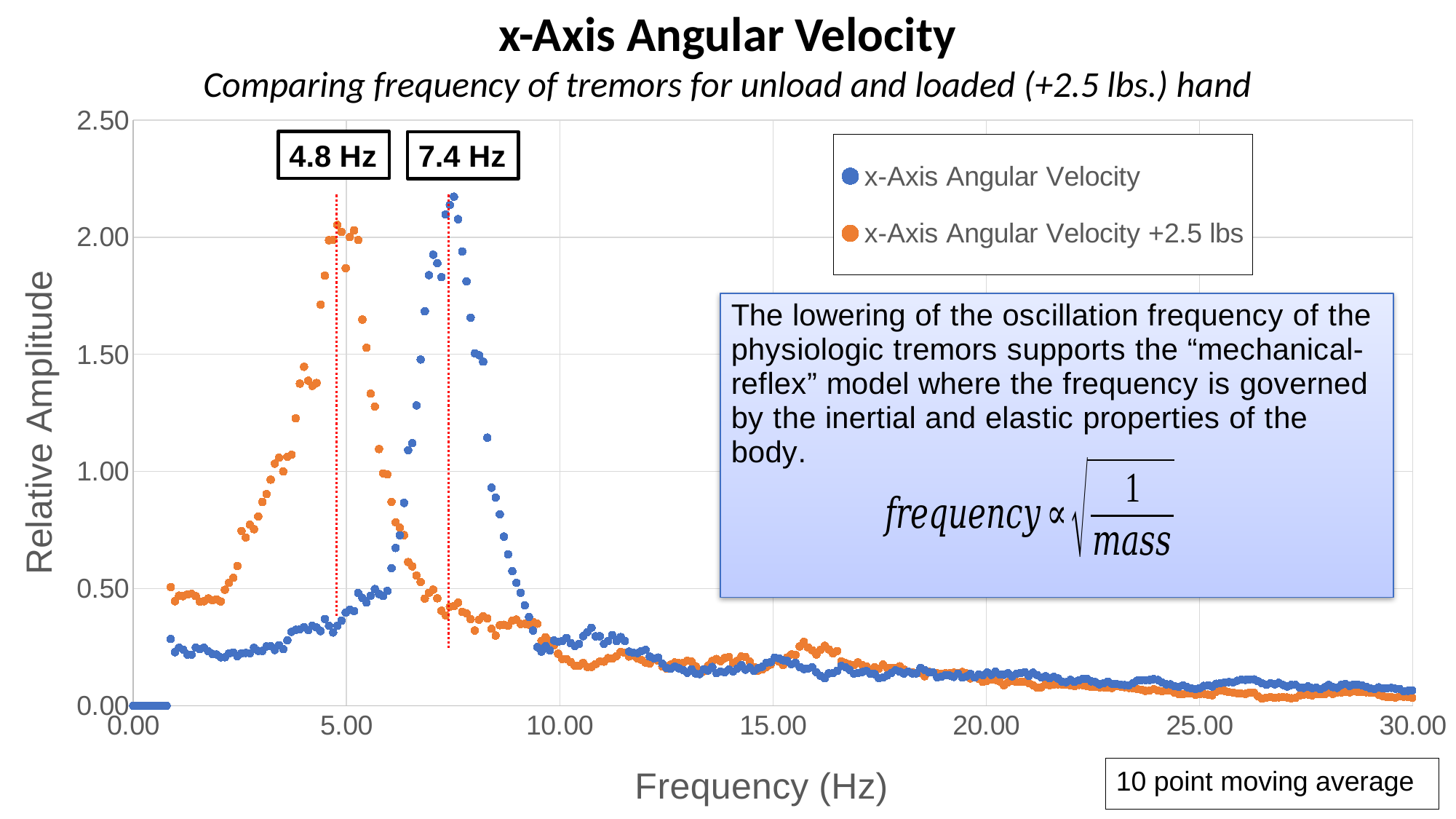
What is the title of the chart? x-Axis Angular Velocity How many series does the legend list? 2 Do the relative amplitude values of both series rise or fall as frequency increases from 10.00 Hz to 30.00 Hz? fall At what frequency does the unloaded x-Axis Angular Velocity series peak, according to the annotation? 7.4 Hz Which series peaks at the higher frequency, x-Axis Angular Velocity or x-Axis Angular Velocity +2.5 lbs? x-Axis Angular Velocity What kind of chart is shown on the slide? scatter chart What is the label of the x axis? Frequency (Hz) Is the relative amplitude of the x-Axis Angular Velocity series at 20.00 Hz greater or less than 0.50? less What is the difference between the two annotated peak frequencies, 7.4 Hz and 4.8 Hz? 2.6 Hz Is the peak relative amplitude of the x-Axis Angular Velocity +2.5 lbs series greater or less than 1.50? greater At what frequency does the loaded (+2.5 lbs) series peak, according to the annotation? 4.8 Hz Is the peak relative amplitude of the x-Axis Angular Velocity series greater or less than 2.00? greater